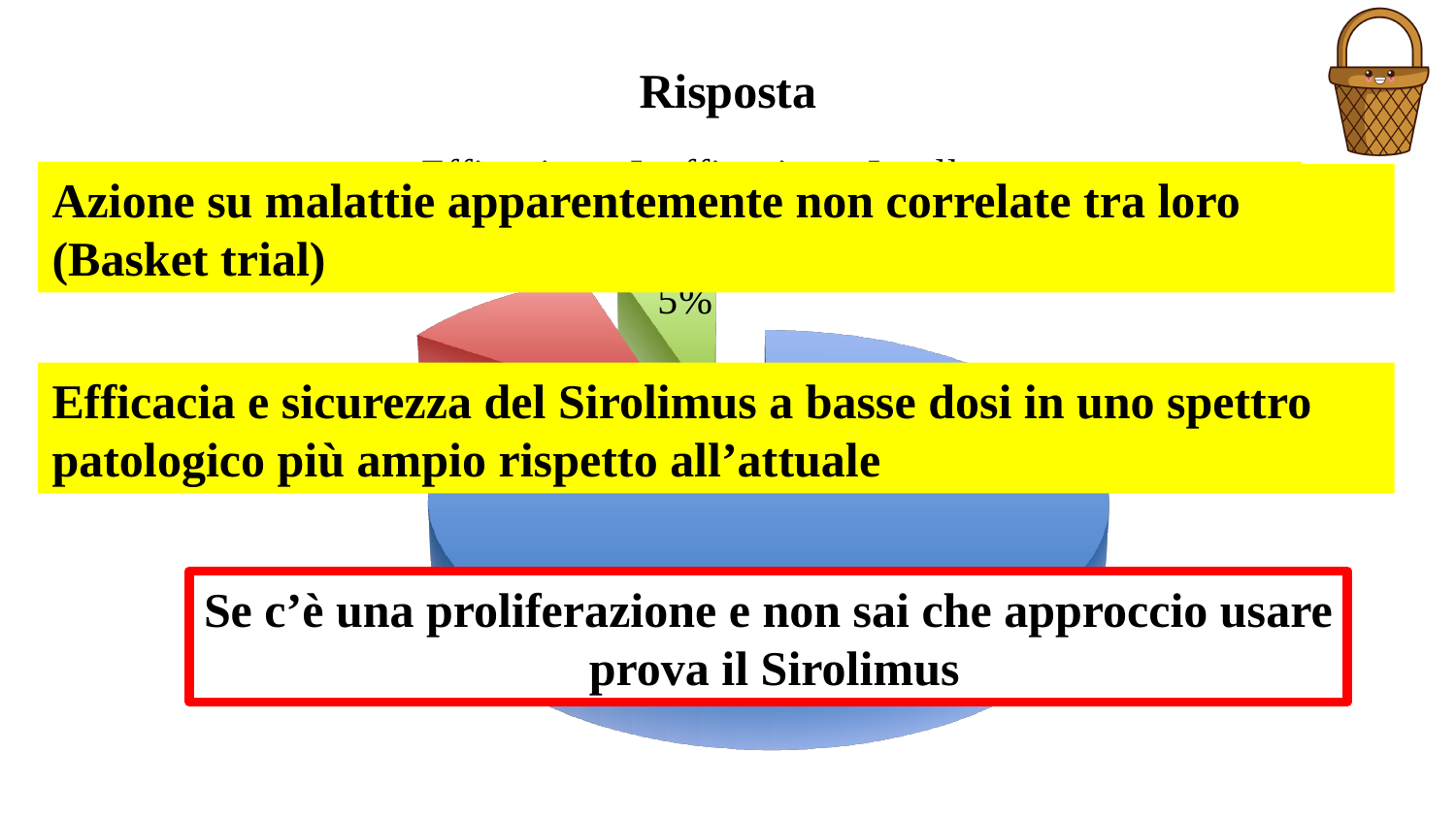
Which is larger in the pie chart, the red slice or the green slice? the red slice Which colour slice of the pie chart is the largest? blue What kind of chart is partially visible on the slide? pie chart What share of the pie does the green slice represent? 5% Which is larger in the pie chart, the blue slice or the green slice? the blue slice What percentage is printed on the green slice of the pie chart? 5%